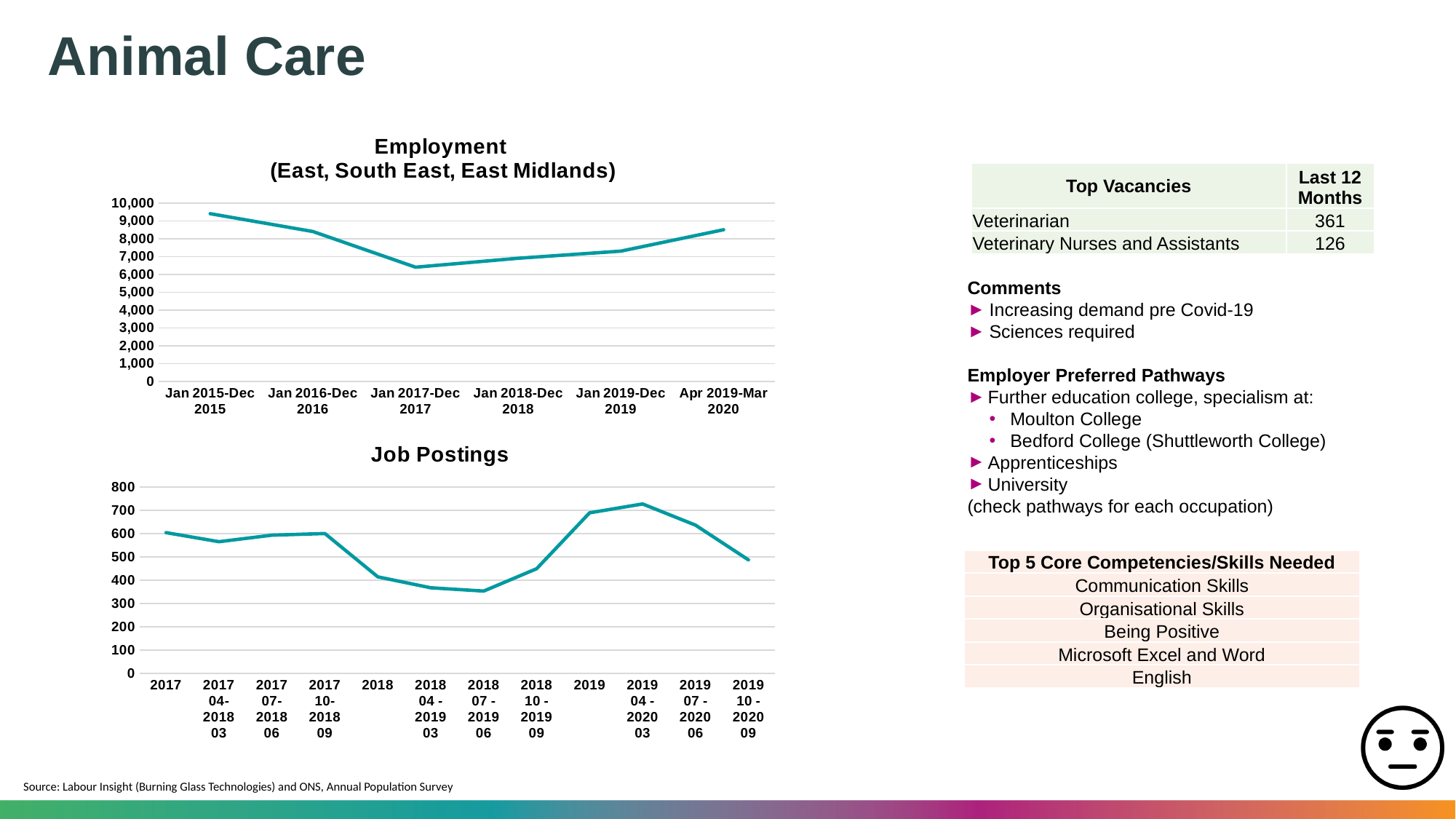
On the Job Postings chart, which period has more job postings: 2019 04 - 2020 03 or 2018 07 - 2019 06? 2019 04 - 2020 03 On the Job Postings chart, which period has the highest number of job postings? 2019 04 - 2020 03 On the Job Postings chart, is the value for 2019 04 - 2020 03 greater or less than 700? greater How many data points are plotted on the Job Postings chart? 12 On the Employment (East, South East, East Midlands) chart, is the value for Jan 2017-Dec 2017 greater or less than 7,000? less On the Employment (East, South East, East Midlands) chart, which period has the lowest employment? Jan 2017-Dec 2017 On the Employment (East, South East, East Midlands) chart, which period has the highest employment? Jan 2015-Dec 2015 What type of chart is the Employment (East, South East, East Midlands) chart? line chart On the Employment (East, South East, East Midlands) chart, is the value for Jan 2015-Dec 2015 greater or less than 9,000? greater On the Employment (East, South East, East Midlands) chart, do the values rise or fall from Jan 2017-Dec 2017 to Apr 2019-Mar 2020? rise How many periods are shown on the x axis of the Employment (East, South East, East Midlands) chart? 6